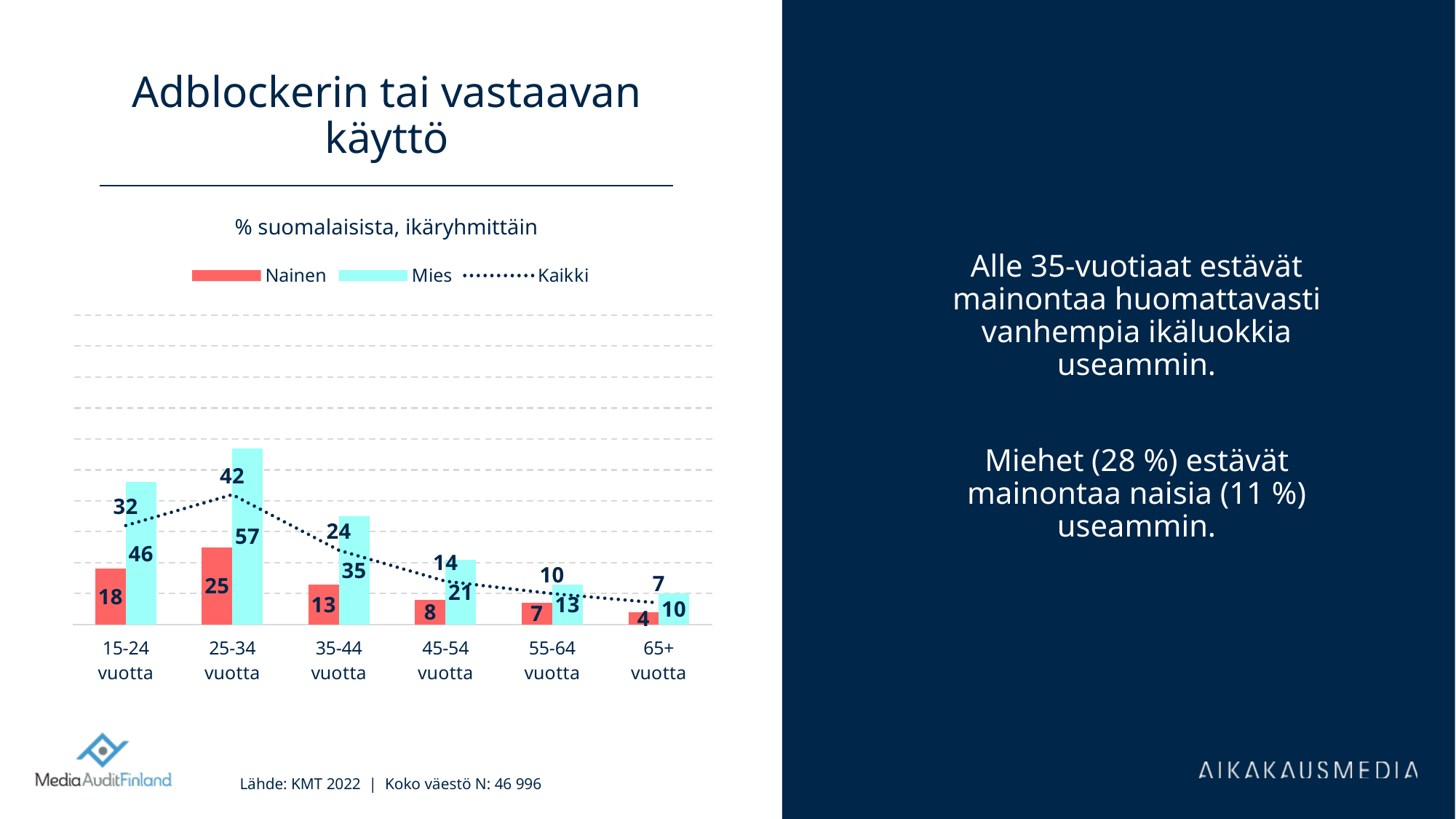
What is the Nainen value for the 65+ vuotta age group? 4 Which is larger for the 45-54 vuotta age group, the Nainen value or the Mies value? Mies What is the Kaikki value for the 35-44 vuotta age group? 24 What is the Nainen value for the 15-24 vuotta age group? 18 What kind of chart is used to plot the Nainen and Mies series? bar chart Which age group has the lowest Nainen value? 65+ vuotta How many series does the legend list? 3 What is the Mies value for the 25-34 vuotta age group? 57 How many age groups are shown on the x axis? 6 Do the Kaikki values rise or fall from the 25-34 vuotta group to the 65+ vuotta group? fall What is the difference between the Mies and Nainen values for the 25-34 vuotta age group? 32 Which age group has the highest Mies value? 25-34 vuotta